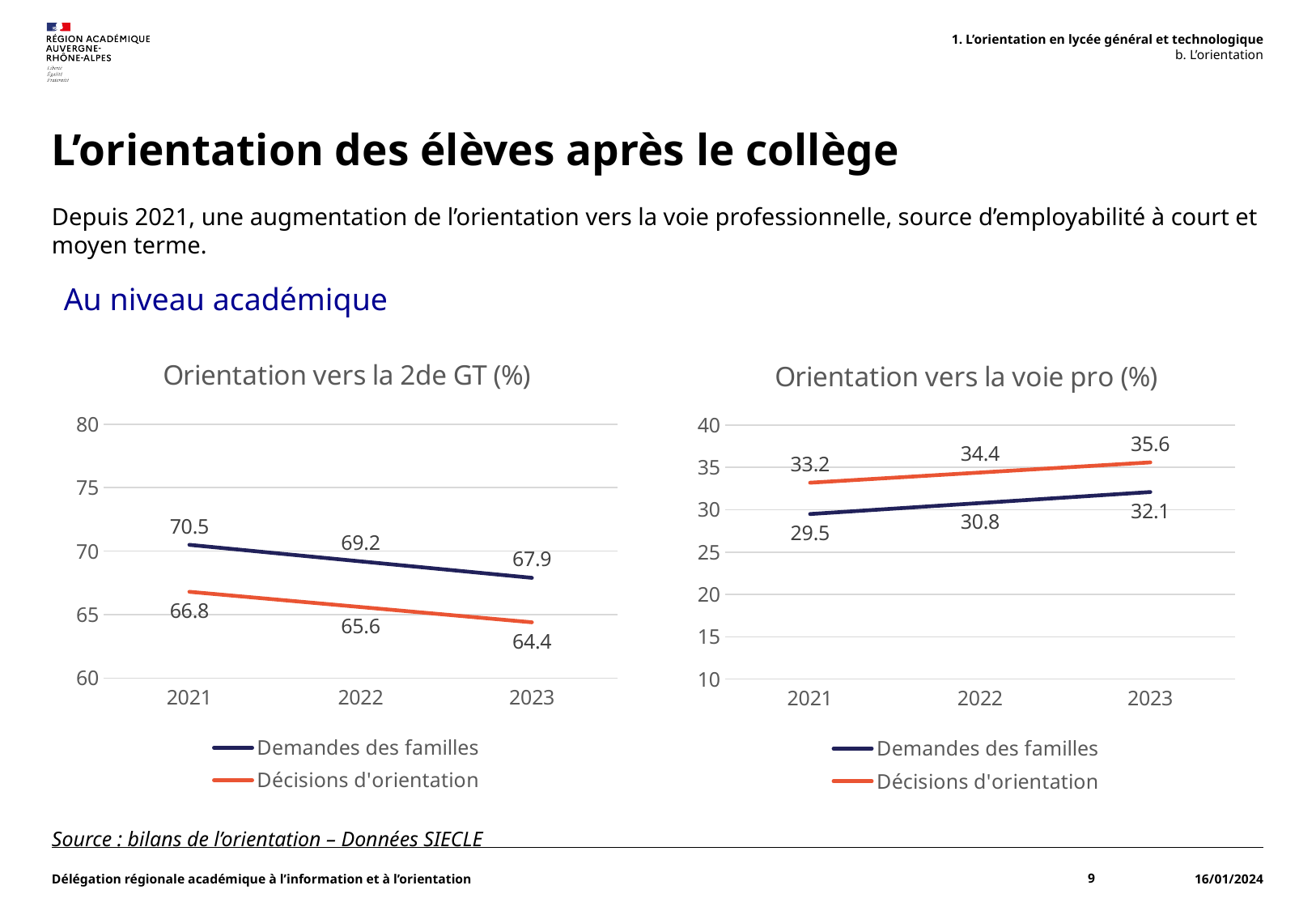
In the chart 'Orientation vers la voie pro (%)', which series is higher in 2021, Demandes des familles or Décisions d'orientation? Décisions d'orientation In the chart 'Orientation vers la 2de GT (%)', what is the difference between Demandes des familles and Décisions d'orientation in 2022? 3.6 In the chart 'Orientation vers la 2de GT (%)', in which year is Demandes des familles highest? 2021 In the chart 'Orientation vers la voie pro (%)', in which year is Décisions d'orientation lowest? 2021 In the chart 'Orientation vers la 2de GT (%)', what is the value for Demandes des familles in 2021? 70.5 What kind of chart is 'Orientation vers la 2de GT (%)'? line chart In the chart 'Orientation vers la voie pro (%)', how many series does the legend list? 2 In the chart 'Orientation vers la 2de GT (%)', does Décisions d'orientation rise or fall from 2021 to 2023? fall In the chart 'Orientation vers la voie pro (%)', what is the value for Demandes des familles in 2023? 32.1 In the chart 'Orientation vers la voie pro (%)', what is the difference between Décisions d'orientation in 2023 and in 2021? 2.4 In the chart 'Orientation vers la 2de GT (%)', what is the value for Décisions d'orientation in 2023? 64.4 In the chart 'Orientation vers la voie pro (%)', what is the value for Décisions d'orientation in 2022? 34.4